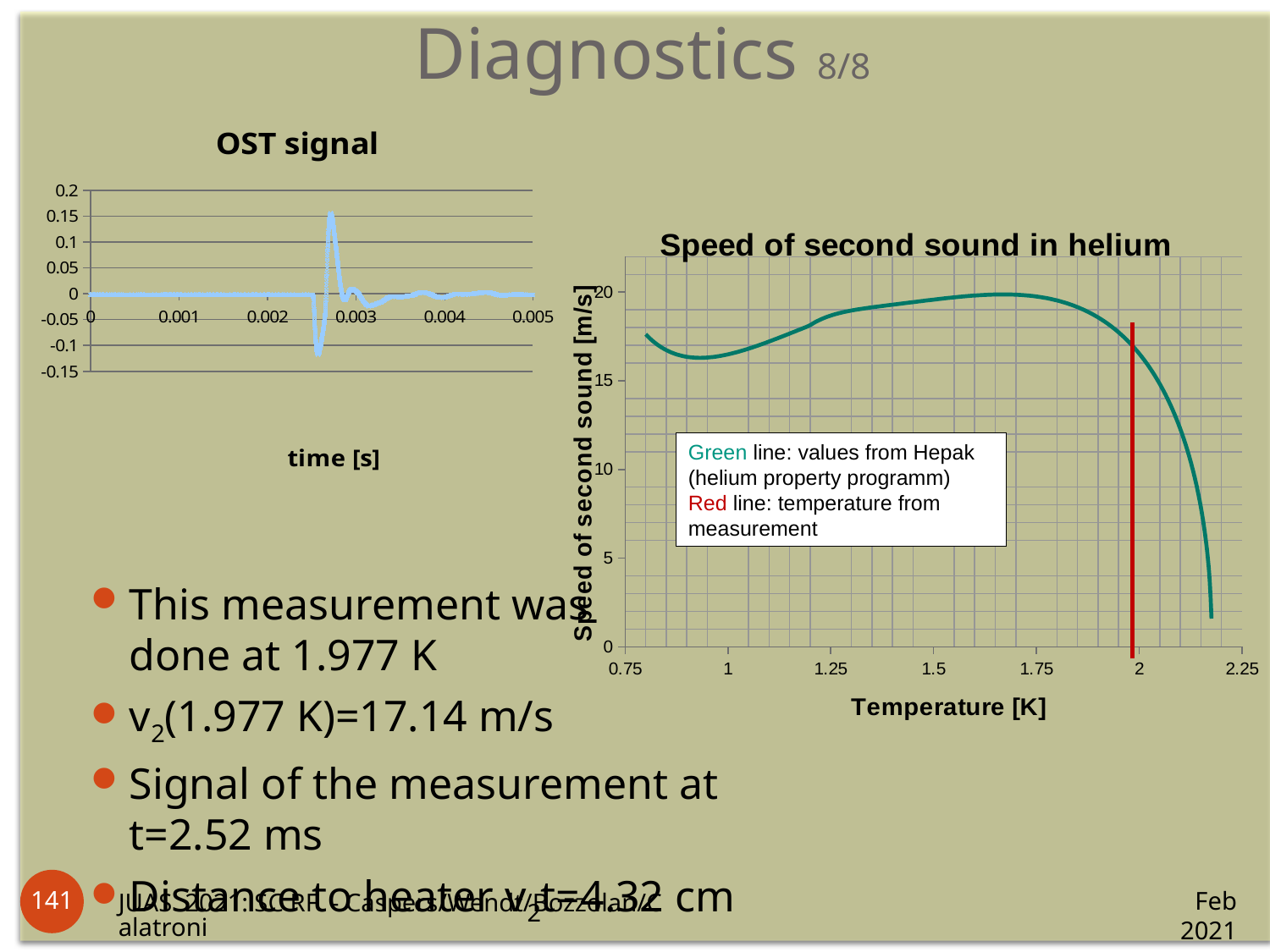
In the 'Speed of second sound in helium' chart, does the green line rise or fall between 1 K and 1.5 K? rise What kind of chart is the 'OST signal' chart? line chart In the 'Speed of second sound in helium' chart, what is the label of the y axis? Speed of second sound [m/s] In the 'OST signal' chart, is the lowest value of the signal greater or less than -0.1? less What kind of chart is the 'Speed of second sound in helium' chart? line chart In the 'Speed of second sound in helium' chart, is the speed at 1.5 K greater or less than 15? greater In the 'OST signal' chart, is the peak value of the signal greater or less than 0.1? greater In the 'Speed of second sound in helium' chart, does the green line rise or fall between 1.75 K and 2.25 K? fall In the 'Speed of second sound in helium' chart, is the speed higher at 1.5 K or at 2.15 K? 1.5 K In the 'OST signal' chart, what is the label of the x axis? time [s]